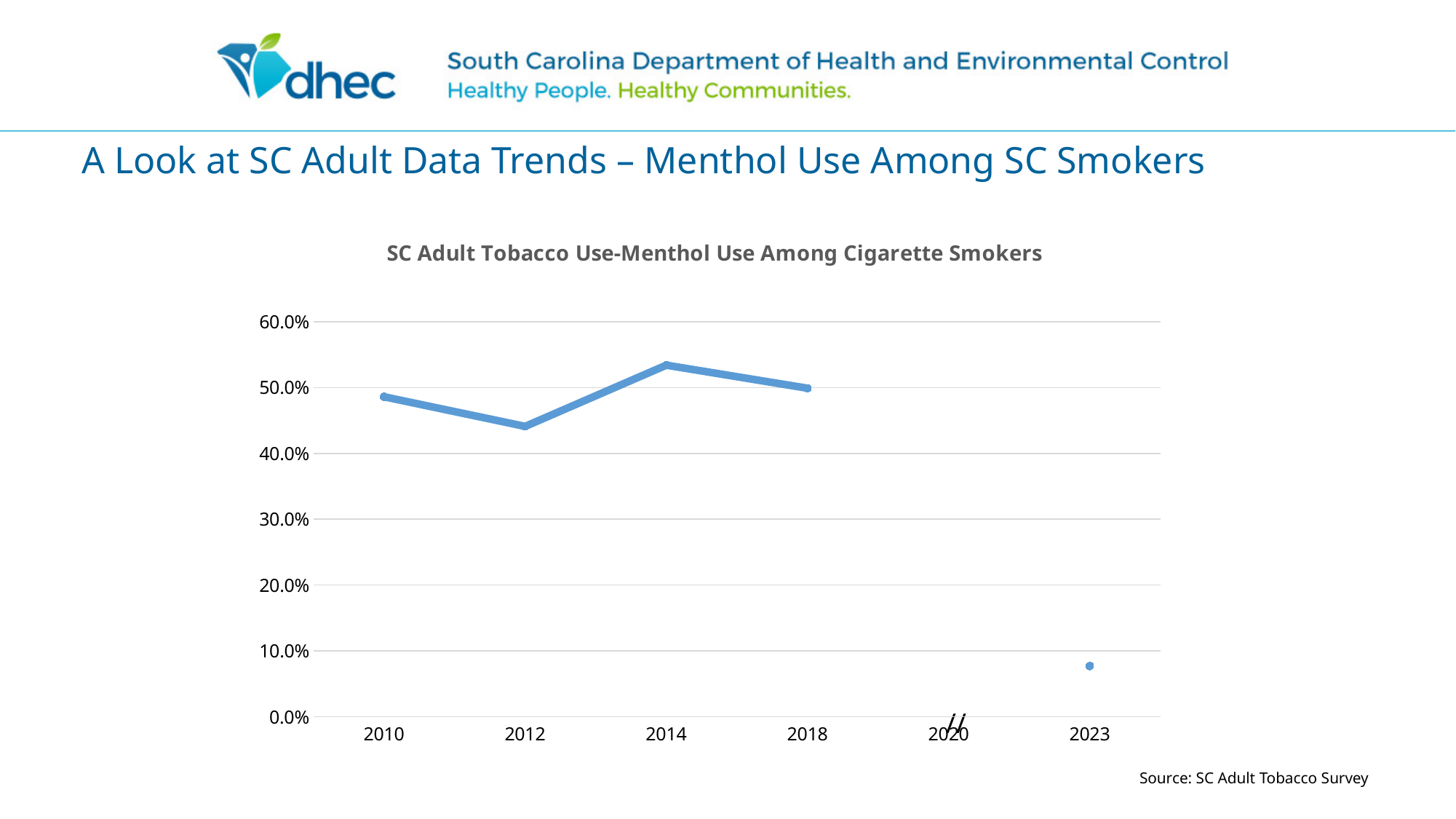
Is the value for 2010 greater or less than 40.0%? greater Which year has the larger value, 2010 or 2012? 2010 What kind of chart is shown on the slide? Line chart Is the value for 2014 greater or less than 50.0%? greater Does the value rise or fall from 2012 to 2014? Rise What source is cited for the chart data? SC Adult Tobacco Survey Is the value for 2012 greater or less than 50.0%? less Which year has the highest menthol use value on the chart? 2014 What is the title of the chart? SC Adult Tobacco Use-Menthol Use Among Cigarette Smokers Which year has the lowest menthol use value on the chart? 2023 How many year labels are shown on the x axis? 6